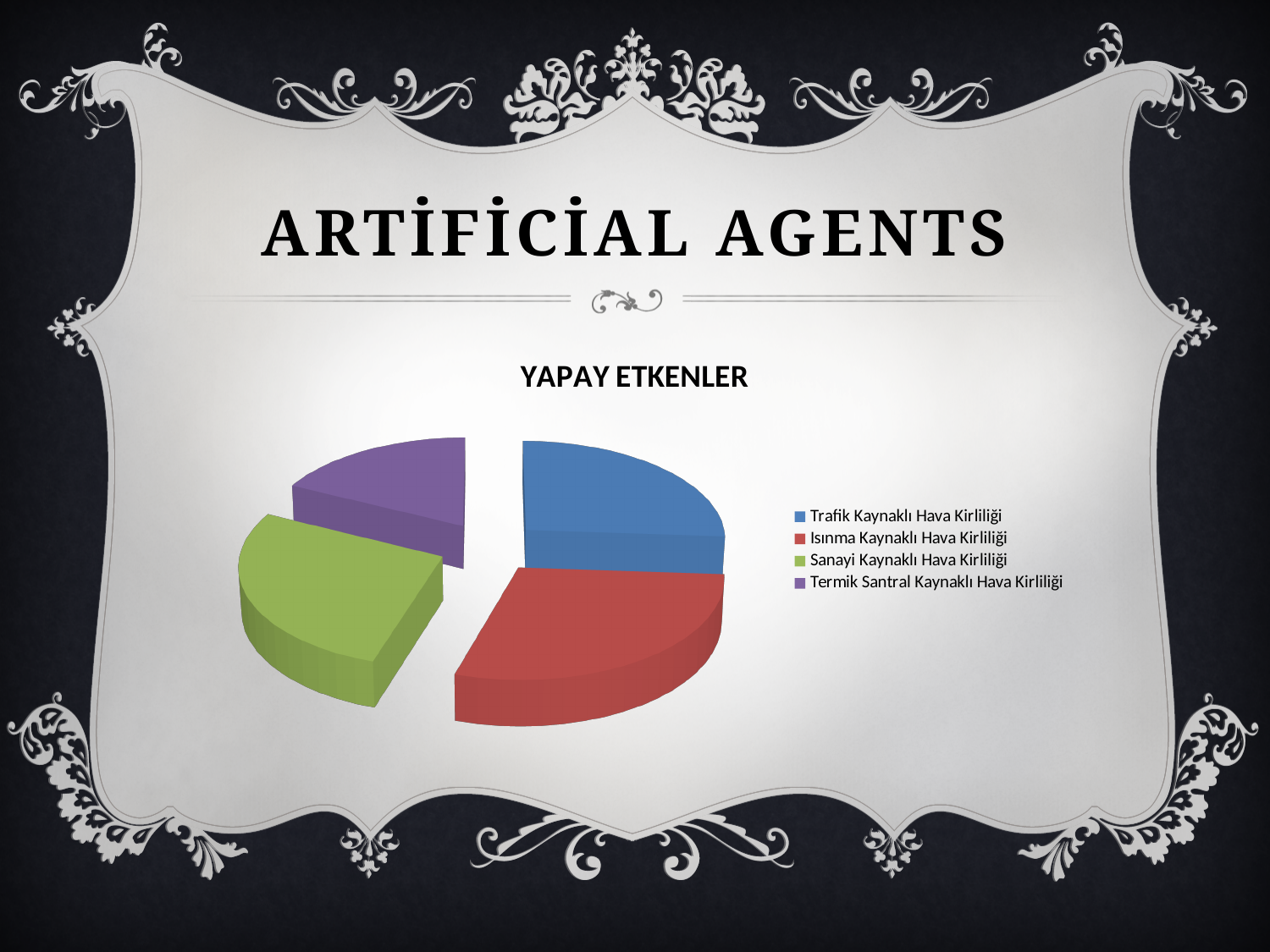
Which colour represents Sanayi Kaynaklı Hava Kirliliği in the pie chart? green Which slice is larger: Isınma Kaynaklı Hava Kirliliği or Termik Santral Kaynaklı Hava Kirliliği? Isınma Kaynaklı Hava Kirliliği Which slice is larger: Sanayi Kaynaklı Hava Kirliliği or Termik Santral Kaynaklı Hava Kirliliği? Sanayi Kaynaklı Hava Kirliliği What is the title of the pie chart? YAPAY ETKENLER What kind of chart is shown on the slide? pie chart How many entries does the legend of the pie chart list? 4 How many slices does the pie chart have? 4 Which category has the smallest slice in the pie chart? Termik Santral Kaynaklı Hava Kirliliği